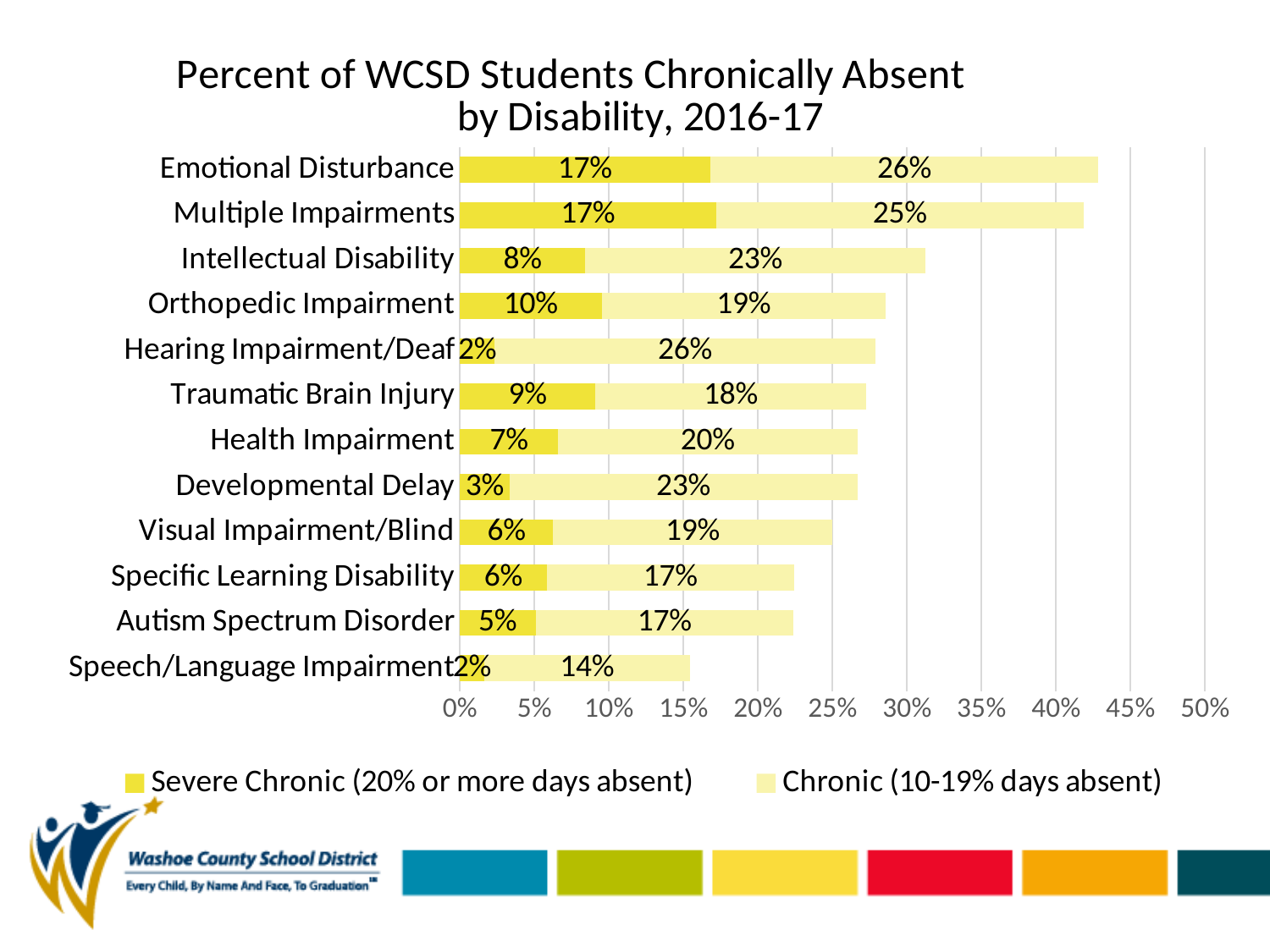
What is the difference between the Chronic values for Emotional Disturbance and Speech/Language Impairment? 12% What is the Severe Chronic (20% or more days absent) value for Orthopedic Impairment? 10% What is the Chronic (10-19% days absent) value for Developmental Delay? 23% What is the Severe Chronic value for Traumatic Brain Injury? 9% Which is larger, the Severe Chronic value for Intellectual Disability or for Health Impairment? Intellectual Disability What type of chart is shown on the slide? Stacked bar chart What is the total of the stacked bar for Multiple Impairments? 42% Which disability category has the lowest Chronic (10-19% days absent) value? Speech/Language Impairment Is the total bar for Emotional Disturbance greater or less than 40%? greater How many disability categories are shown in the chart? 12 How many series does the legend list? 2 What is the title of the chart? Percent of WCSD Students Chronically Absent by Disability, 2016-17